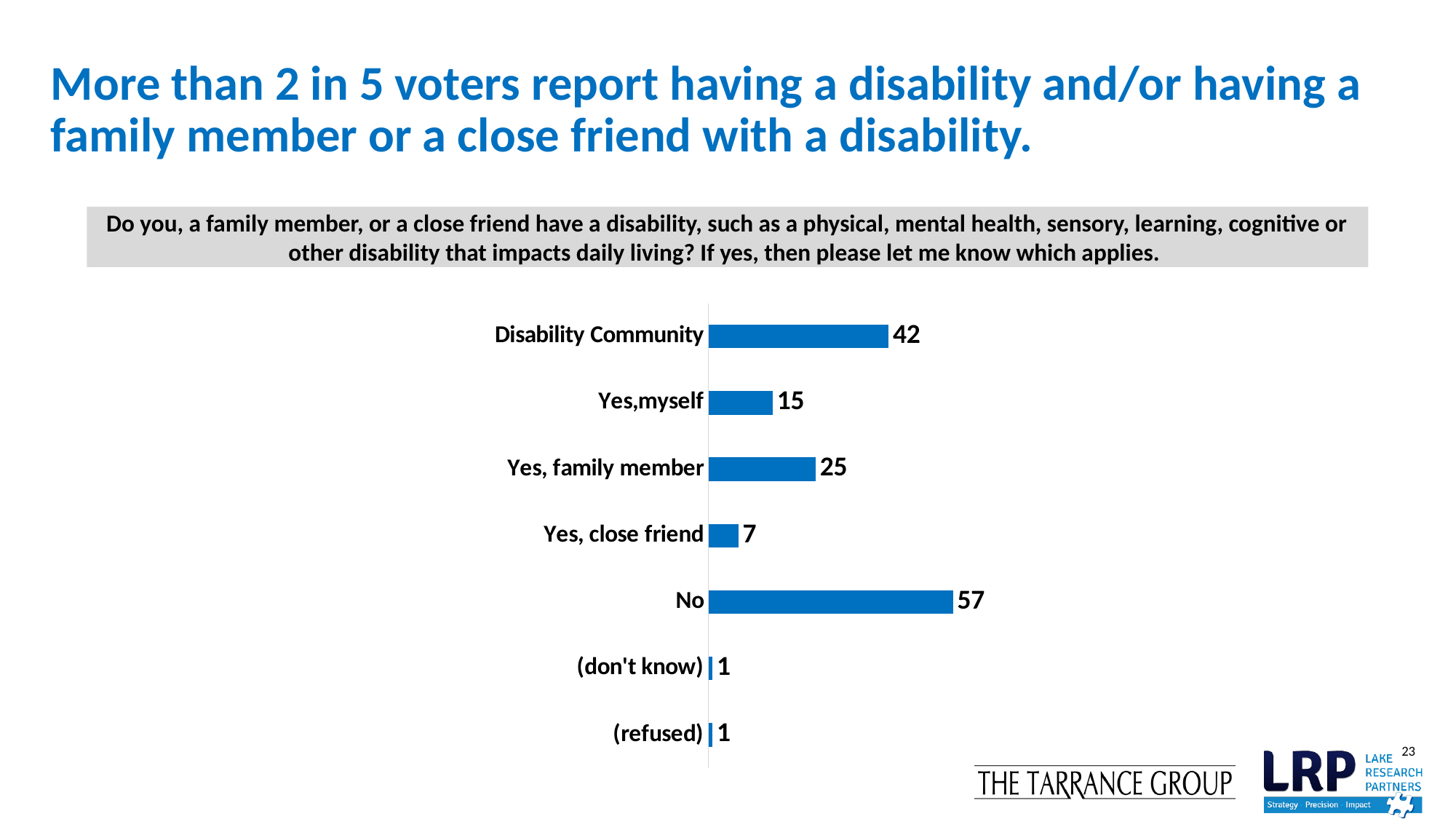
Which category has the highest value? No What is the difference between the values for Yes, family member and Yes,myself? 10 What is the value for No? 57 What colour are the bars in the chart? blue Which is larger, the value for Yes,myself or the value for Yes, close friend? Yes,myself What is the difference between the values for No and Disability Community? 15 What is the value for Disability Community? 42 What is the value for Yes, close friend? 7 How many categories are shown in the chart? 7 What is the value for (don't know)? 1 What is the value for Yes, family member? 25 What kind of chart is shown on the slide? bar chart